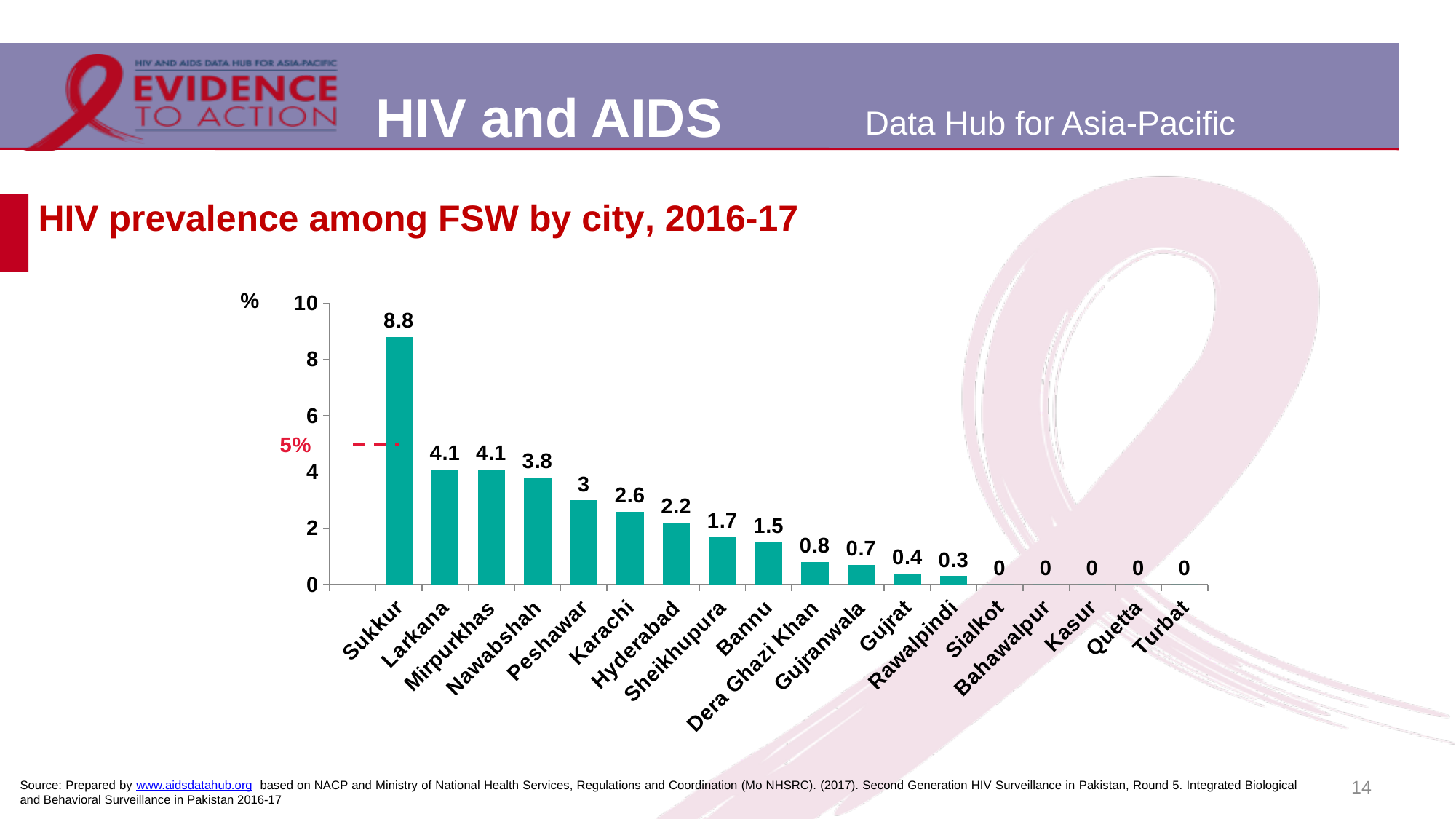
What kind of chart is shown on the slide? Bar chart How many cities are shown on the chart? 18 What is the HIV prevalence among FSW in Karachi? 2.6 What value does the red dashed reference line on the chart mark? 5% What is the difference in HIV prevalence between Sukkur and Nawabshah? 5 Which city has a higher HIV prevalence among FSW, Peshawar or Hyderabad? Peshawar How many cities have an HIV prevalence of 0? 5 Is the value for Sukkur greater or less than 8? greater What is the HIV prevalence among FSW in Sukkur? 8.8 Do the values rise or fall from left to right along the x axis? Fall What is the HIV prevalence among FSW in Dera Ghazi Khan? 0.8 Which city has the highest HIV prevalence among FSW? Sukkur